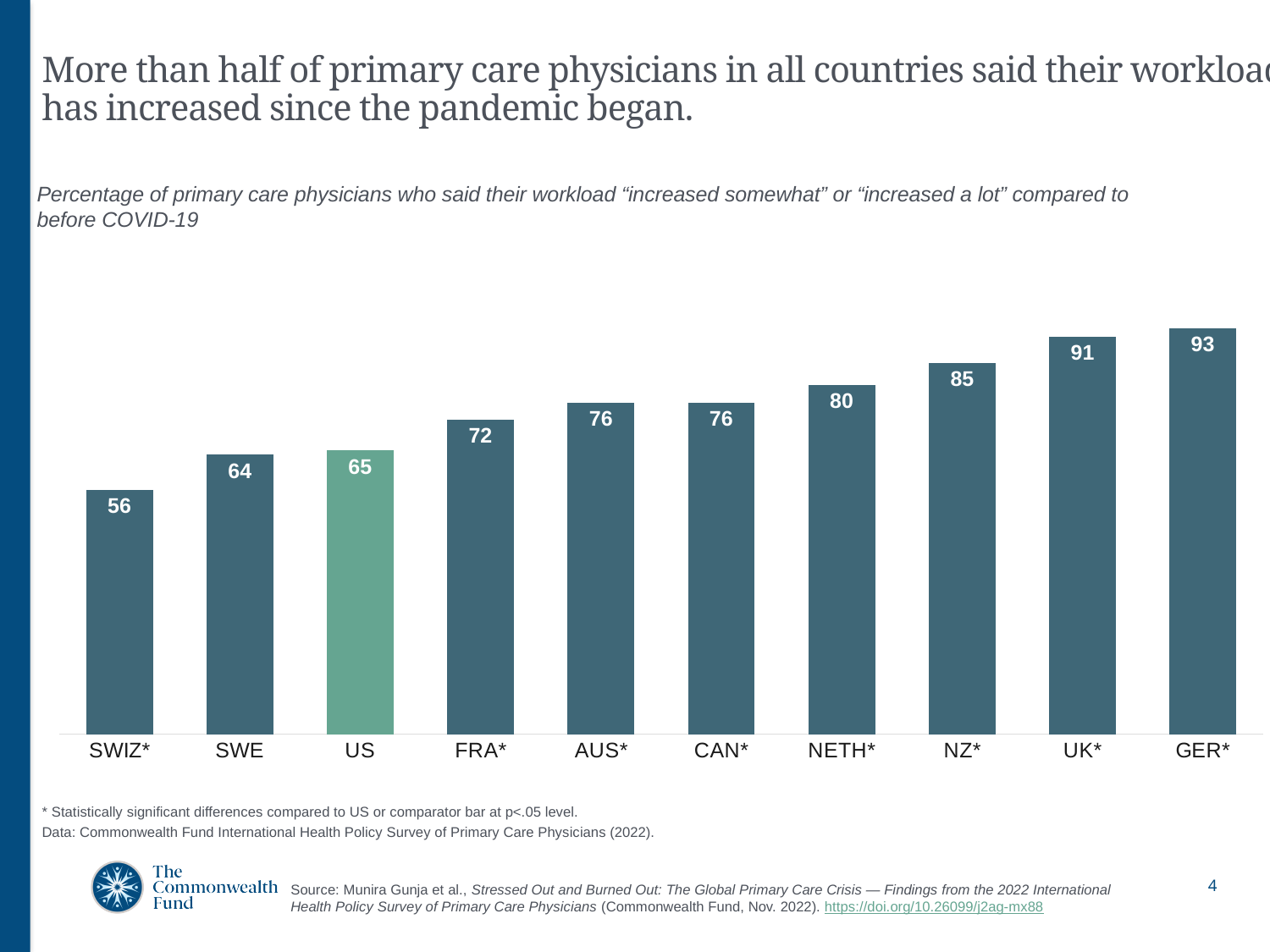
How many countries are shown in the chart? 10 Which country has the lowest value? SWIZ* What kind of chart is shown on the slide? bar chart What is the difference between the values for UK* and SWE? 27 Which country has the highest value? GER* Which is larger, the value for FRA* or the value for NZ*? NZ* Do the values rise or fall moving from left to right along the x axis? rise What is the value for NETH*? 80 Which country's bar is shown in a different colour (green) from the others? US What is the difference between the values for GER* and the US? 28 What is the value for the US? 65 What is the value for SWIZ*? 56